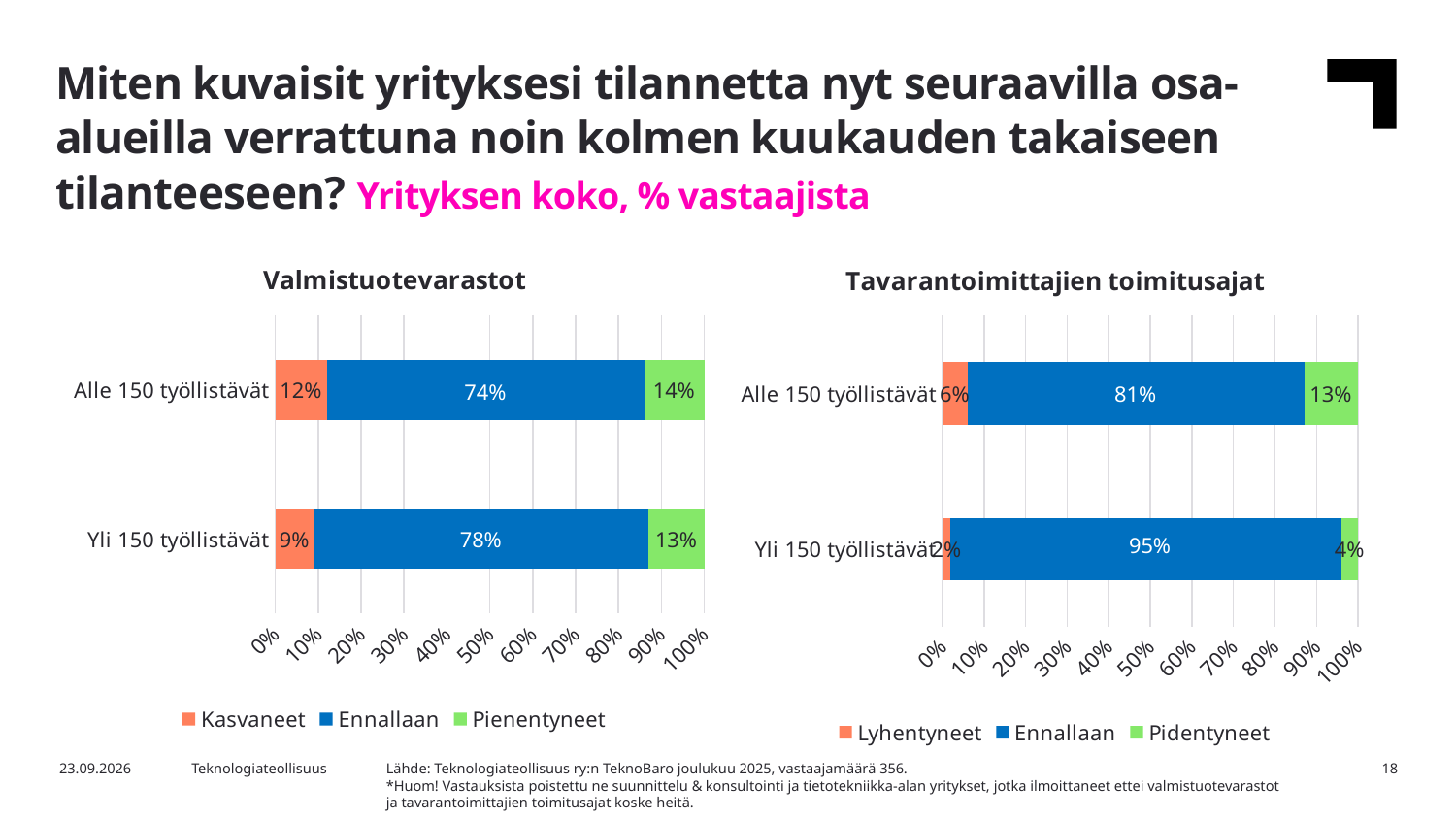
In the Tavarantoimittajien toimitusajat chart, what is the Ennallaan value for Yli 150 työllistävät? 95% What kind of chart is the Valmistuotevarastot chart? Stacked bar chart In the Valmistuotevarastot chart, what is the Ennallaan value for Alle 150 työllistävät? 74% In the Tavarantoimittajien toimitusajat chart, what are the three legend entries? Lyhentyneet, Ennallaan, Pidentyneet In the Tavarantoimittajien toimitusajat chart, what is the Pidentyneet value for Alle 150 työllistävät? 13% How many categories are shown in the Tavarantoimittajien toimitusajat chart? 2 In the Valmistuotevarastot chart, what is the difference between the Ennallaan values for Yli 150 työllistävät and Alle 150 työllistävät? 4% In the Valmistuotevarastot chart, which category has the higher Pienentyneet value? Alle 150 työllistävät How many series does the legend of the Valmistuotevarastot chart list? 3 In the Valmistuotevarastot chart, what is the Kasvaneet value for Yli 150 työllistävät? 9% In the Tavarantoimittajien toimitusajat chart, which category has the larger Lyhentyneet value, Alle 150 työllistävät or Yli 150 työllistävät? Alle 150 työllistävät In the Tavarantoimittajien toimitusajat chart, which category has the lowest Pidentyneet value? Yli 150 työllistävät